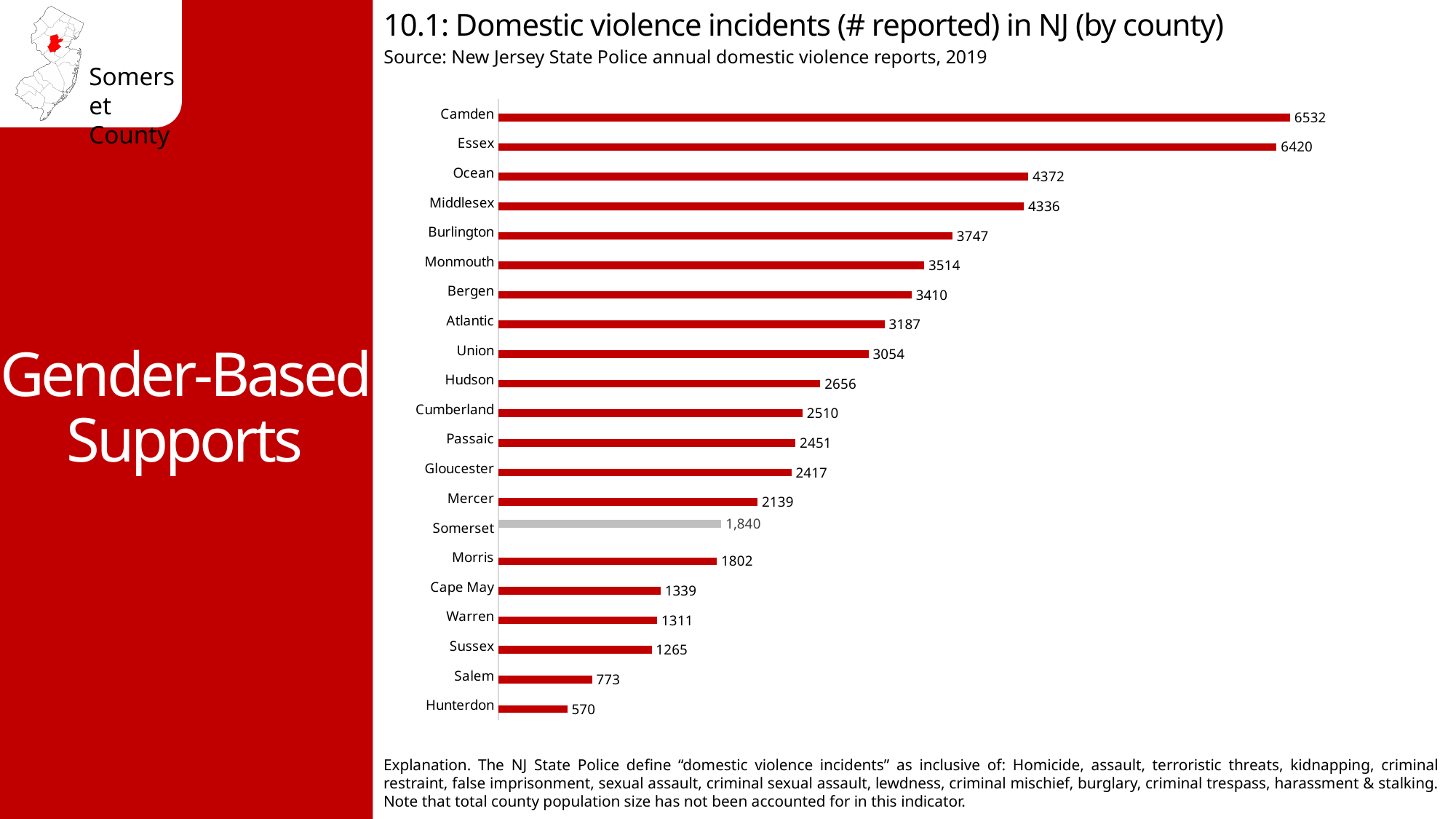
How many counties are shown in the chart? 21 How many domestic violence incidents were reported in Camden county? 6532 What is the difference between the values for Somerset and Morris? 38 What is the difference between the values for Camden and Essex? 112 Which county has more reported incidents, Salem or Sussex? Sussex Which county has the highest number of reported domestic violence incidents? Camden How many domestic violence incidents were reported in Hunterdon county? 570 Which county has more reported incidents, Burlington or Monmouth? Burlington Which county's bar is shown in grey rather than red? Somerset Which county has the lowest number of reported domestic violence incidents? Hunterdon What kind of chart is shown on the slide? Bar chart What is the value shown for Somerset county? 1,840